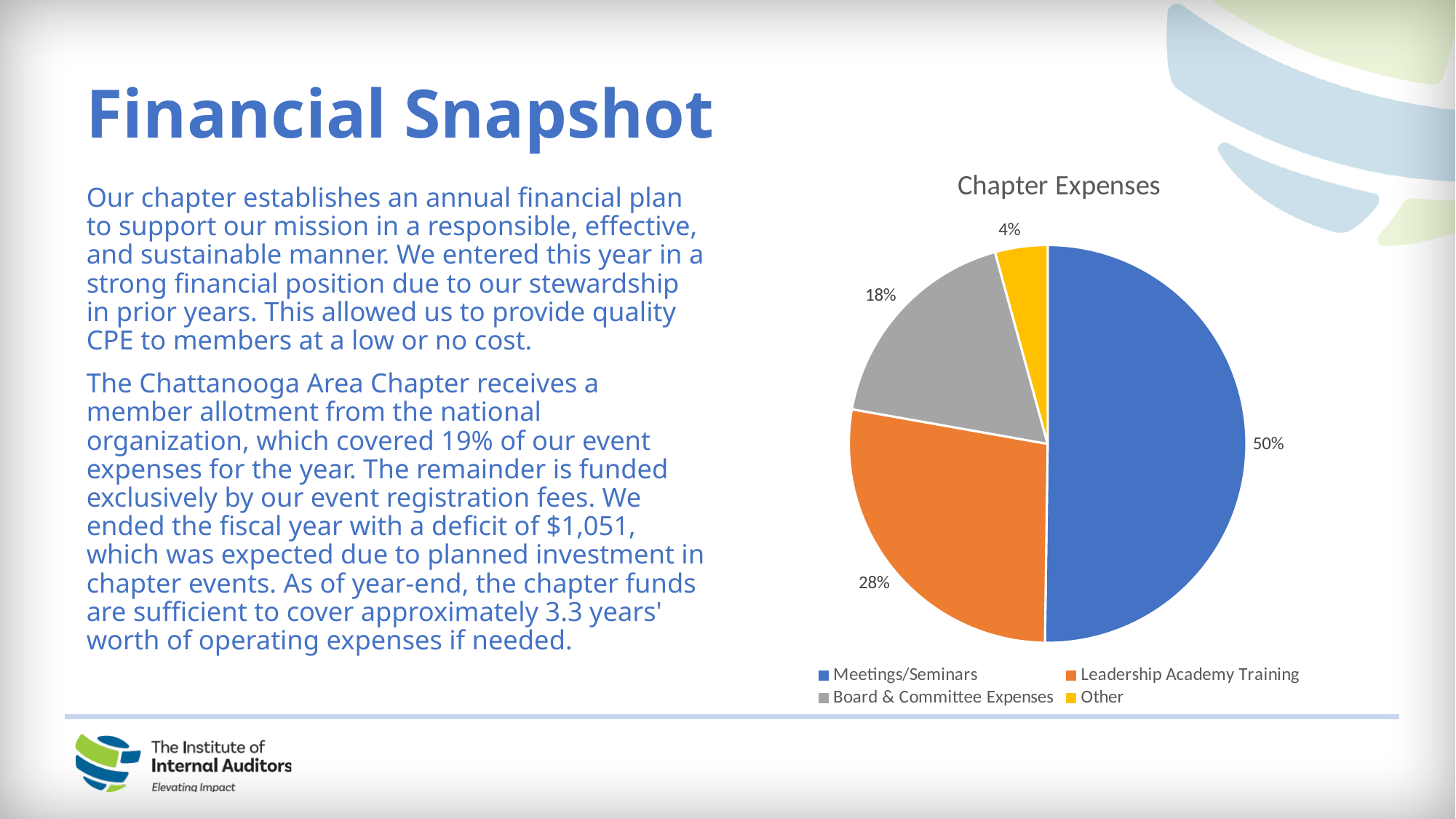
What share of chapter expenses is Board & Committee Expenses? 18% What share of chapter expenses is Leadership Academy Training? 28% Which category accounts for the largest share of chapter expenses? Meetings/Seminars Which is larger, the share for Board & Committee Expenses or the share for Leadership Academy Training? Leadership Academy Training What is the difference in percentage points between Meetings/Seminars and Leadership Academy Training? 22 What type of chart is shown on the slide? Pie chart What share of chapter expenses is Meetings/Seminars? 50% What share of chapter expenses is Other? 4% What is the title of the chart? Chapter Expenses What colour represents Other in the pie chart? Yellow Which category accounts for the smallest share of chapter expenses? Other How many categories does the pie chart show? 4